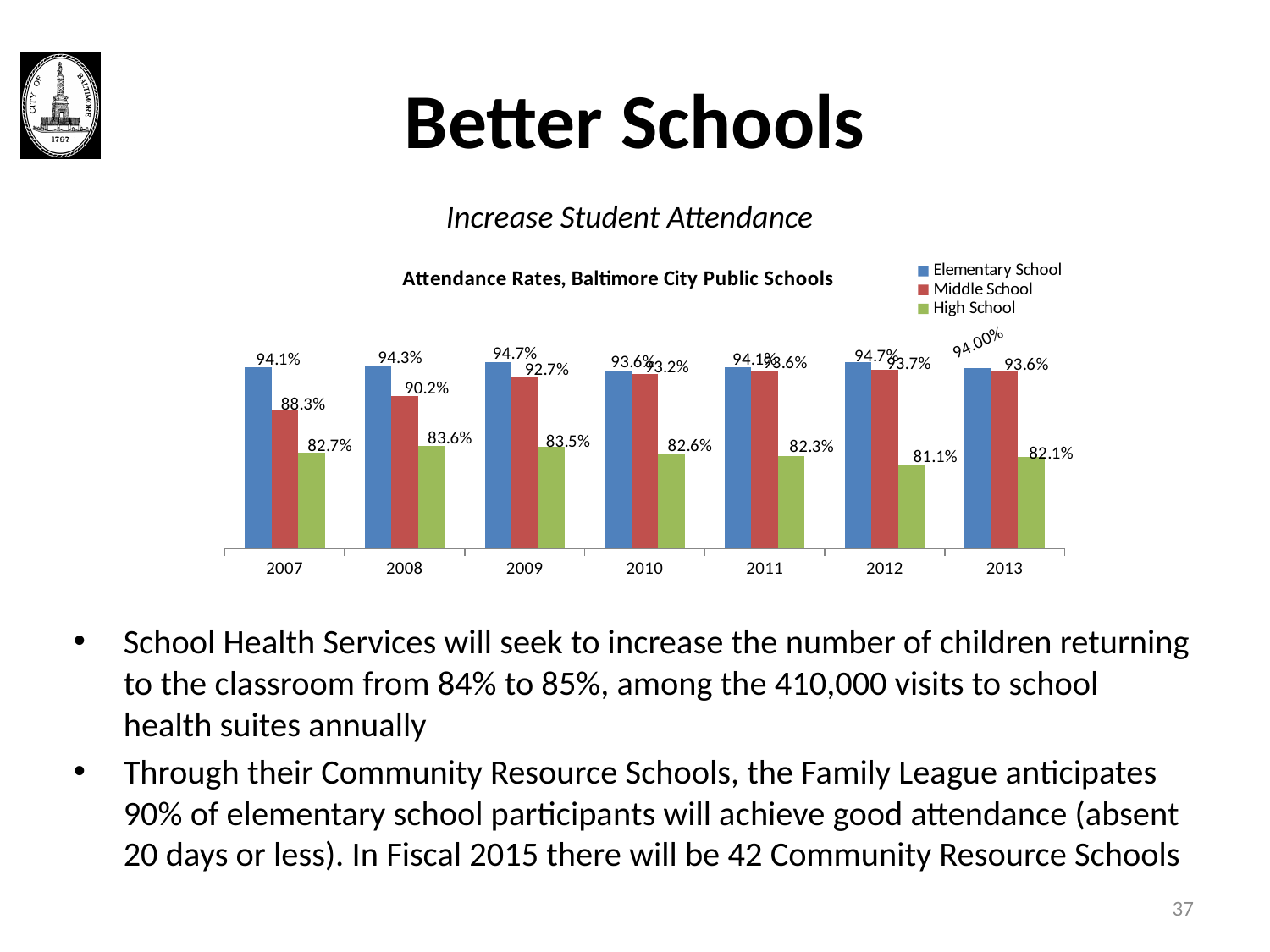
In which year is the High School attendance rate lowest? 2012 What is the Middle School attendance rate for 2008? 90.2% How many years are shown on the x axis of the chart? 7 Does the Middle School attendance rate rise or fall from 2007 to 2010? Rises What is the Elementary School attendance rate for 2013? 94.00% What is the difference between the Elementary School and Middle School attendance rates in 2007? 5.8% Which year has the higher Middle School attendance rate, 2007 or 2009? 2009 What is the High School attendance rate for 2012? 81.1% How many series does the chart's legend list? 3 What is the Elementary School attendance rate for 2007? 94.1% What type of chart is shown on the slide? Bar chart In which year is the Middle School attendance rate lowest? 2007